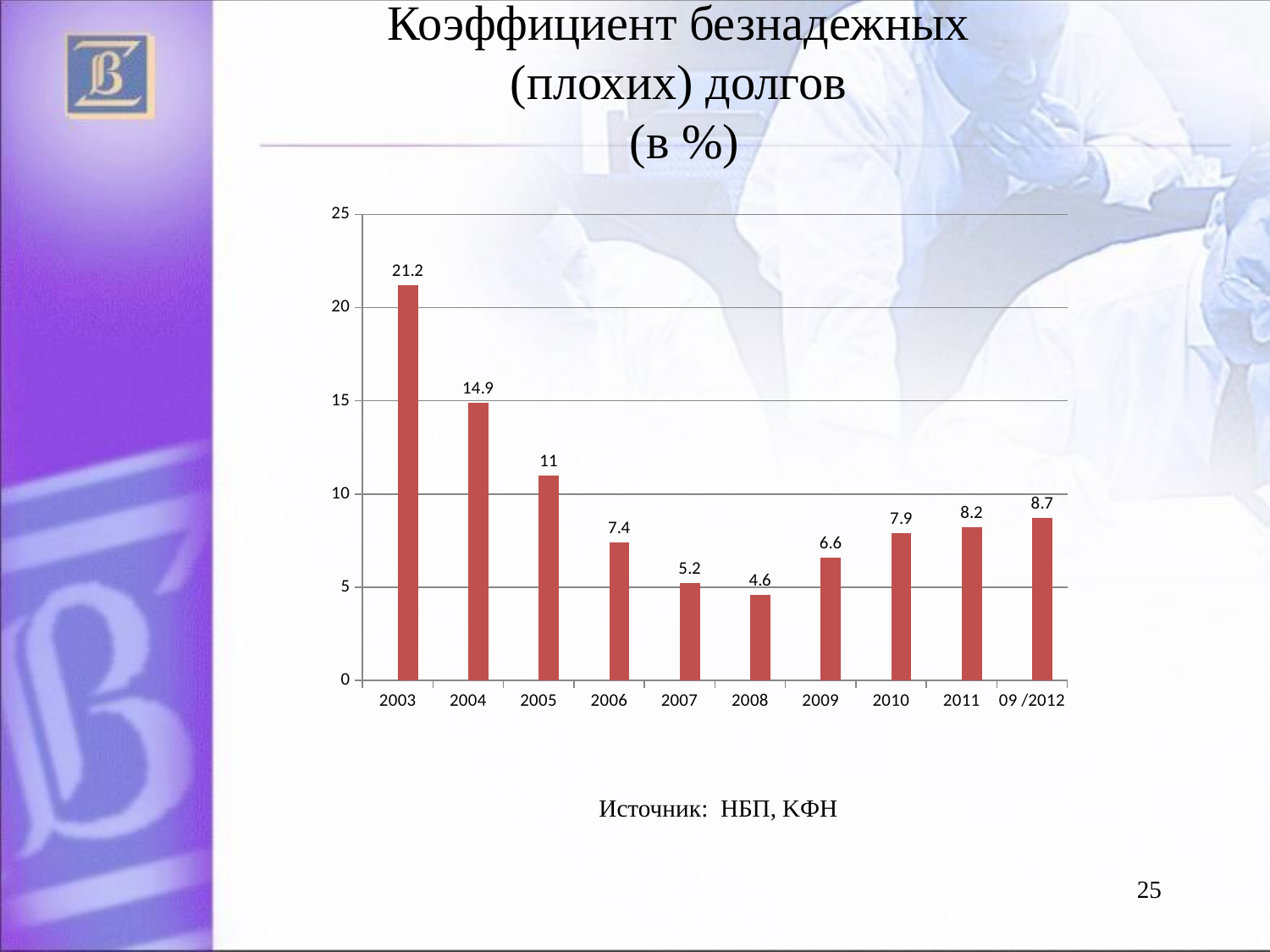
What is the difference between the values for 2003 and 2004? 6.3 What is the value for 2008? 4.6 What kind of chart is shown on the slide? bar chart What is the value for 2003? 21.2 Which year has the highest value? 2003 Do the values rise or fall from 2003 to 2008? fall What is the difference between the values for 2011 and 2010? 0.3 Is the value for 2005 greater or less than 10? greater How many bars are shown in the chart? 10 Which year has the lowest value? 2008 What is the value for 09/2012? 8.7 Which is larger, the value for 2006 or the value for 2009? 2006